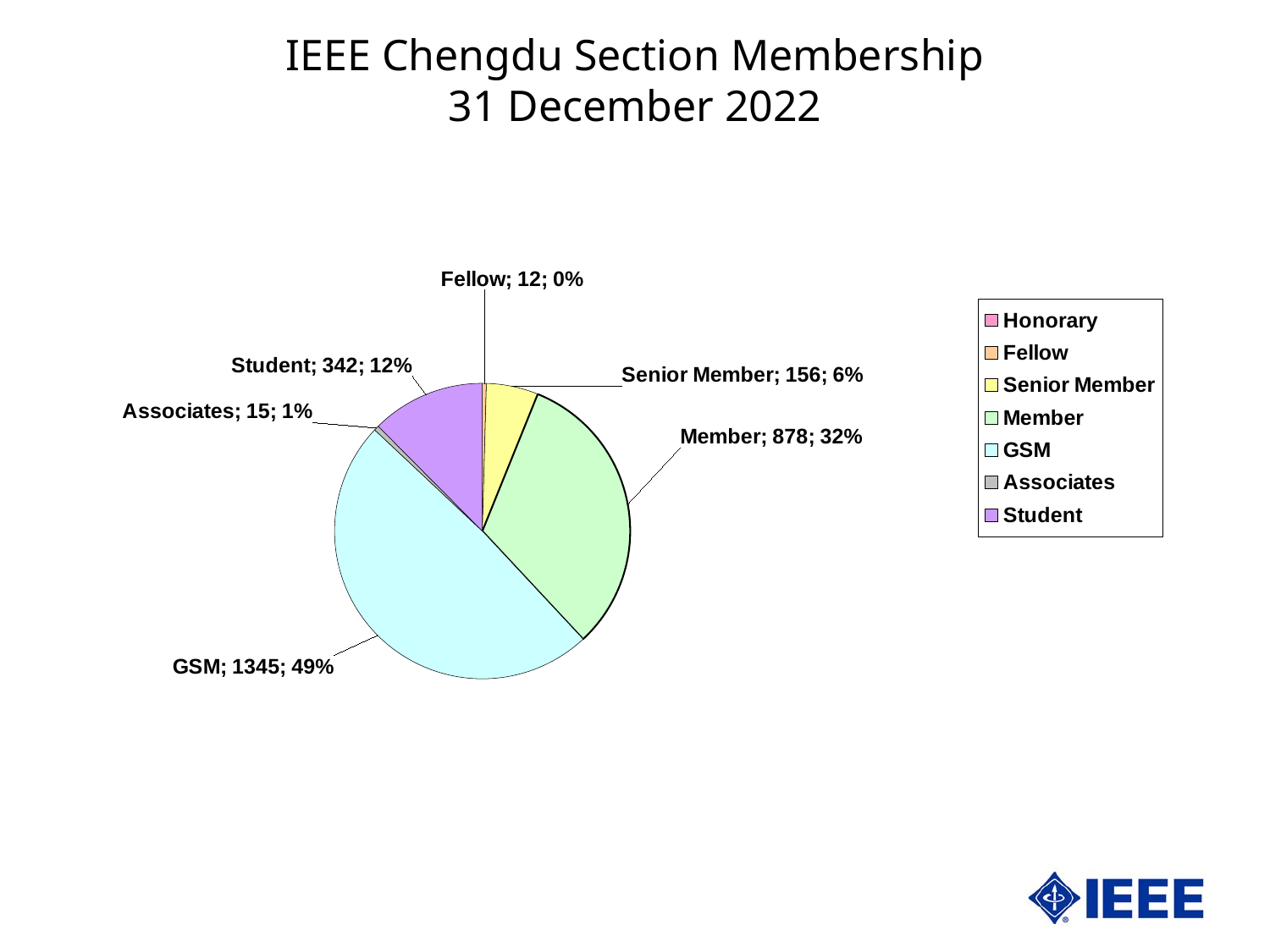
What share of the pie does the Member slice represent? 32% How many entries does the legend list? 7 What is the value shown for Fellow? 12 What kind of chart is shown on the slide? pie chart Which category has the largest slice of the pie? GSM Which is larger, the value for Student or the value for Senior Member? Student What share of the pie does the GSM slice represent? 49% What is the value shown for Member? 878 What is the difference between the GSM value and the Member value? 467 What is the value shown for Student? 342 What is the value shown for Senior Member? 156 How many members does the GSM slice represent? 1345